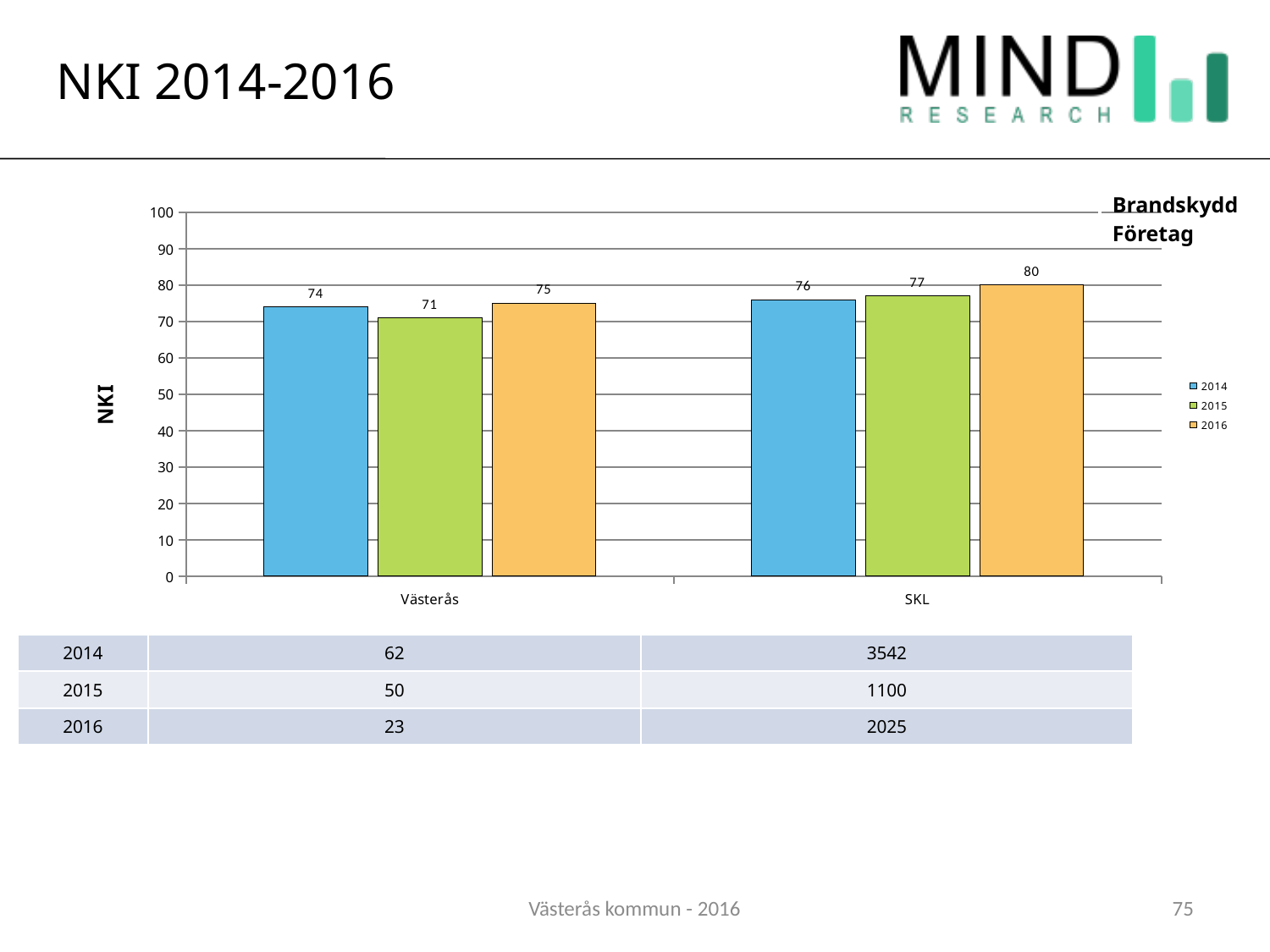
What is the NKI value for Västerås in 2015? 71 Is the NKI value for SKL in 2015 greater or less than 70? greater Which is larger, the 2014 NKI value for Västerås or for SKL? SKL Which year has the lowest NKI value for Västerås? 2015 Which year has the highest NKI value for SKL? 2016 How many series does the legend list? 3 What is the NKI value for Västerås in 2014? 74 How many categories are shown on the x axis? 2 What is the label of the y axis? NKI What is the difference between the SKL and Västerås NKI values in 2016? 5 What is the NKI value for SKL in 2016? 80 What kind of chart is shown on the slide? bar chart